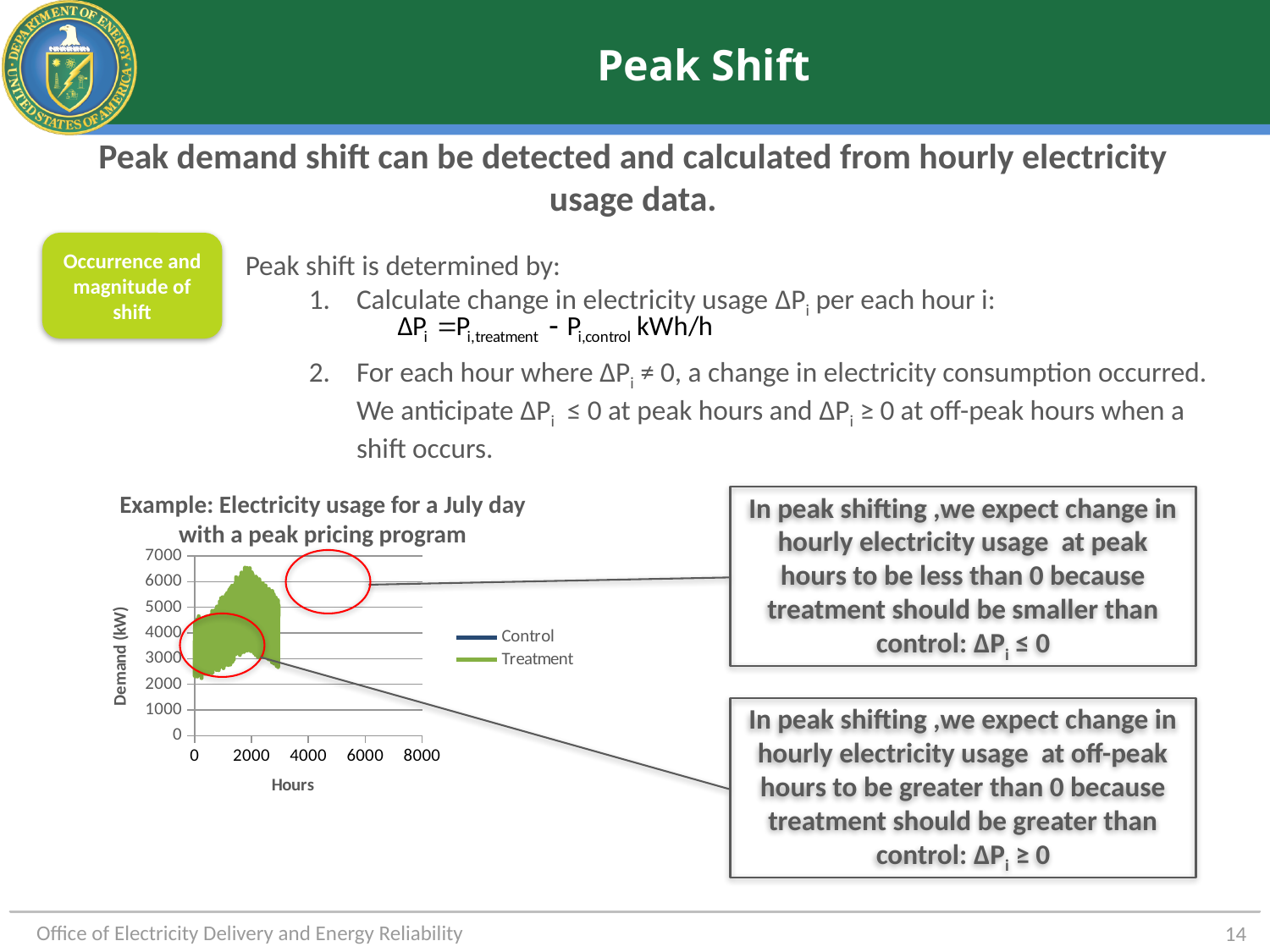
What are the two series named in the chart legend? Control and Treatment What is the highest tick value shown on the chart's vertical axis? 7000 What kind of chart is shown on the slide? line chart What is the title of the chart? Example: Electricity usage for a July day with a peak pricing program What is the highest tick value shown on the chart's horizontal axis? 8000 Which series is drawn in green in the chart? Treatment What is the label on the chart's horizontal axis? Hours Is the lowest value of the Treatment series greater or less than 3000? less How many series does the chart legend list? 2 Is the peak value of the Treatment series greater or less than 7000? less Is the peak value of the Treatment series greater or less than 6000? greater What is the label on the chart's vertical axis? Demand (kW)